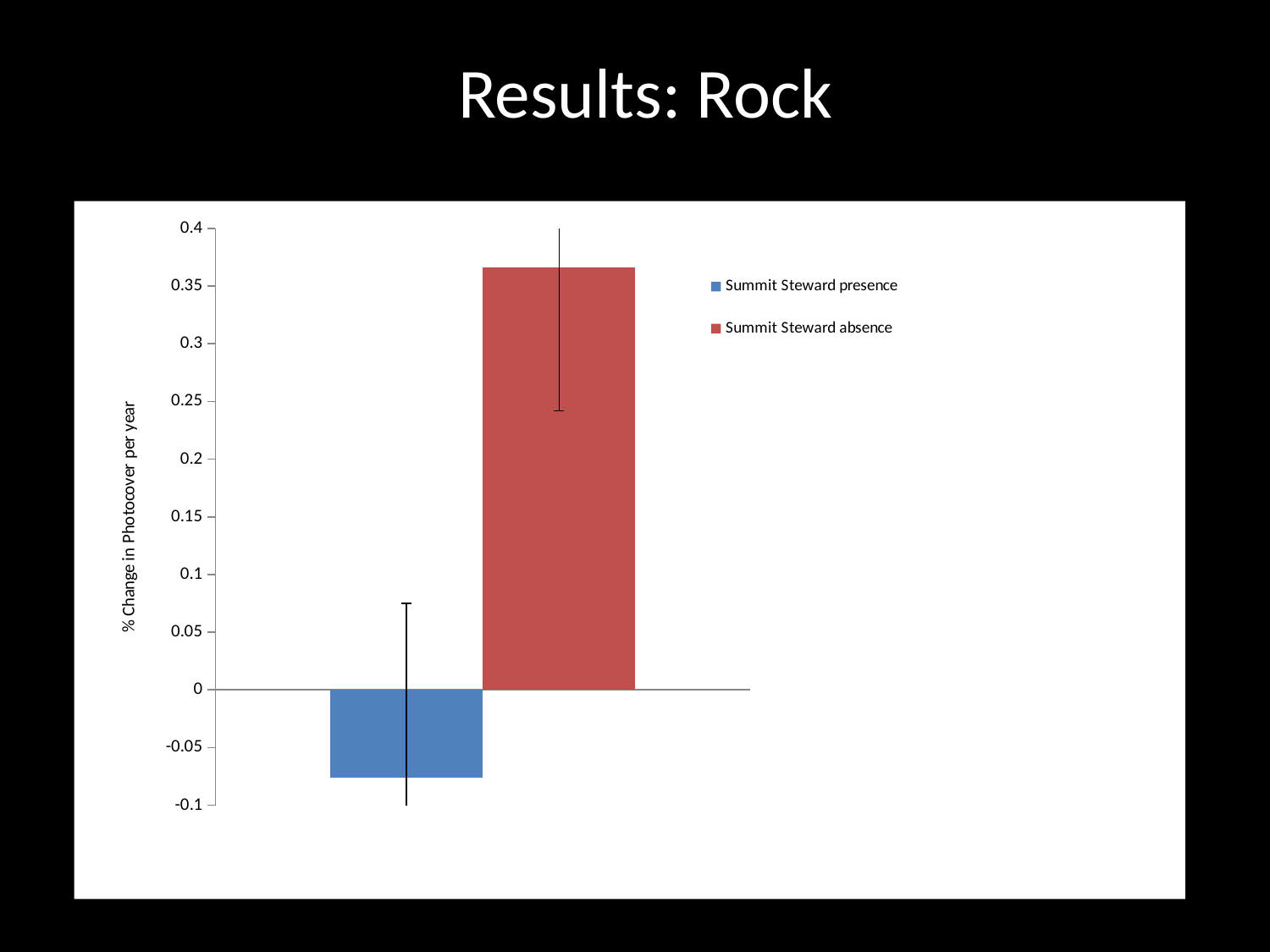
How many bars are plotted in the chart? 2 Is the value for Summit Steward presence greater or less than -0.1? greater What colour is the bar for Summit Steward absence? red Is the value for Summit Steward absence greater or less than 0.4? less Which series has the higher value, Summit Steward presence or Summit Steward absence? Summit Steward absence What is the label of the vertical axis? % Change in Photocover per year Is the value for Summit Steward presence greater or less than 0? less What kind of chart is shown on the slide? bar chart How many series does the legend list? 2 Which series has the lowest value? Summit Steward presence Which series has the highest value? Summit Steward absence